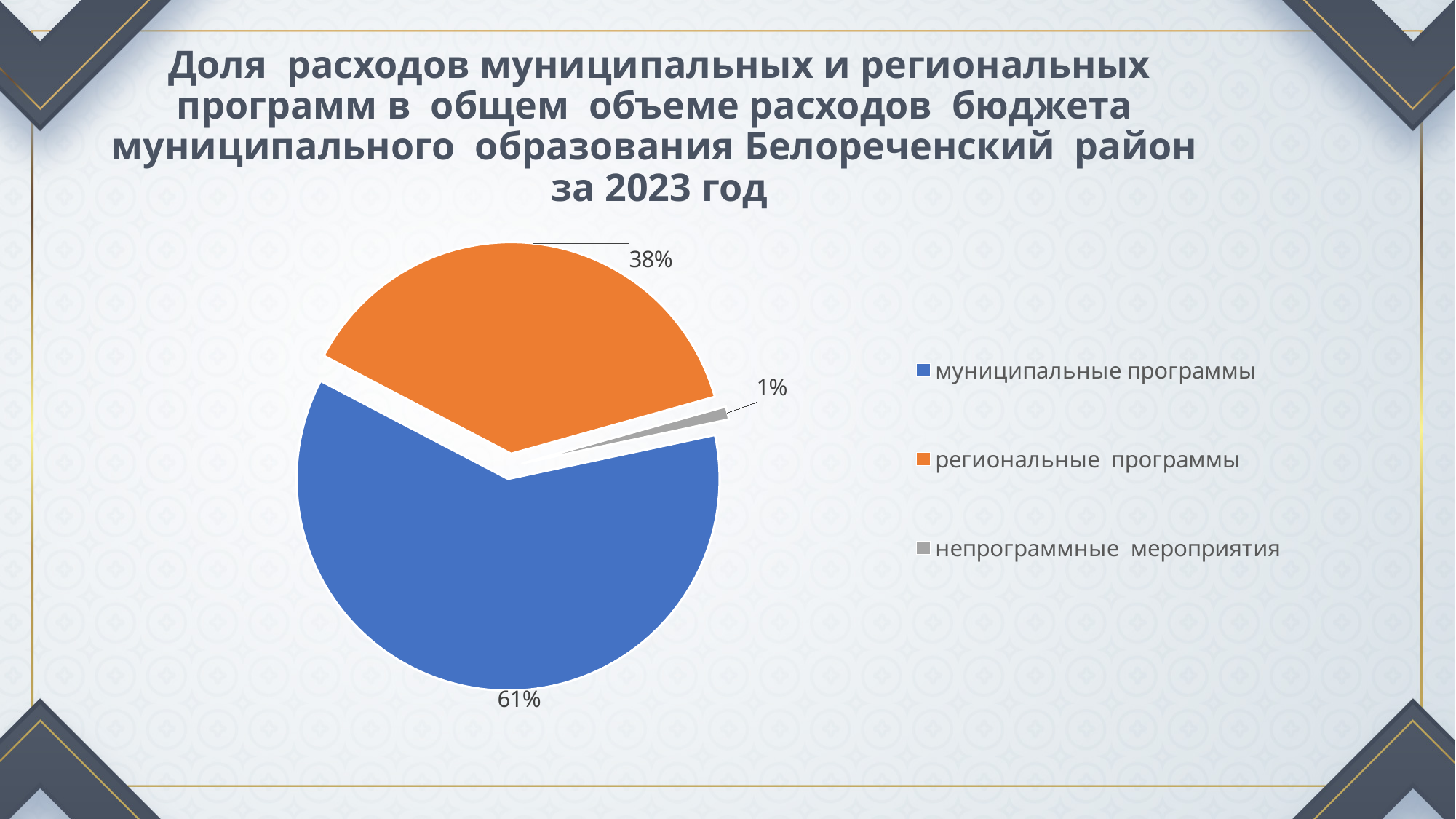
What colour is the slice for региональные программы? orange What share of the pie is региональные программы? 38% What is the difference in percentage points between муниципальные программы and региональные программы? 23 How many entries does the legend list? 3 What kind of chart is shown on the slide? pie chart Which category has the largest share of the pie? муниципальные программы What share of the pie is муниципальные программы? 61% How many categories does the pie chart show? 3 Which is larger: the share for региональные программы or the share for непрограммные мероприятия? региональные программы Which category has the smallest share of the pie? непрограммные мероприятия Which year does the chart title refer to? 2023 What share of the pie is непрограммные мероприятия? 1%